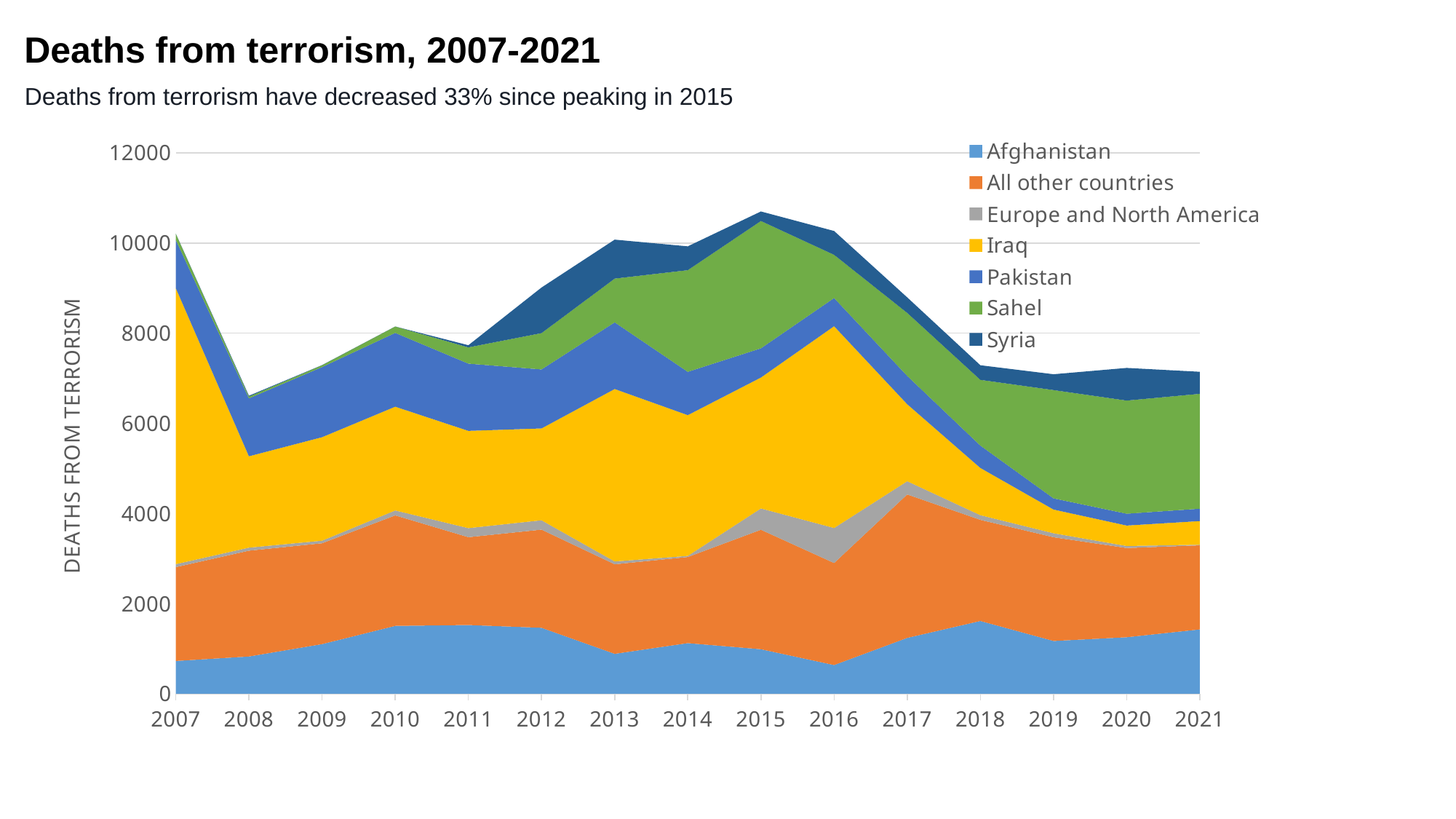
Which year has the lowest total deaths from terrorism? 2008 How many series does the legend list? 7 Is the total value for 2015 greater or less than 10000? greater What kind of chart is shown on the slide? Stacked area chart How many years are plotted along the x axis? 15 Is the total value for 2008 greater or less than 8000? less Which year has a larger total, 2015 or 2008? 2015 Which year has the highest total deaths from terrorism? 2015 Do total deaths from terrorism rise or fall from 2015 to 2021? fall What is the label on the y axis? DEATHS FROM TERRORISM Is the total value for 2021 greater or less than 8000? less